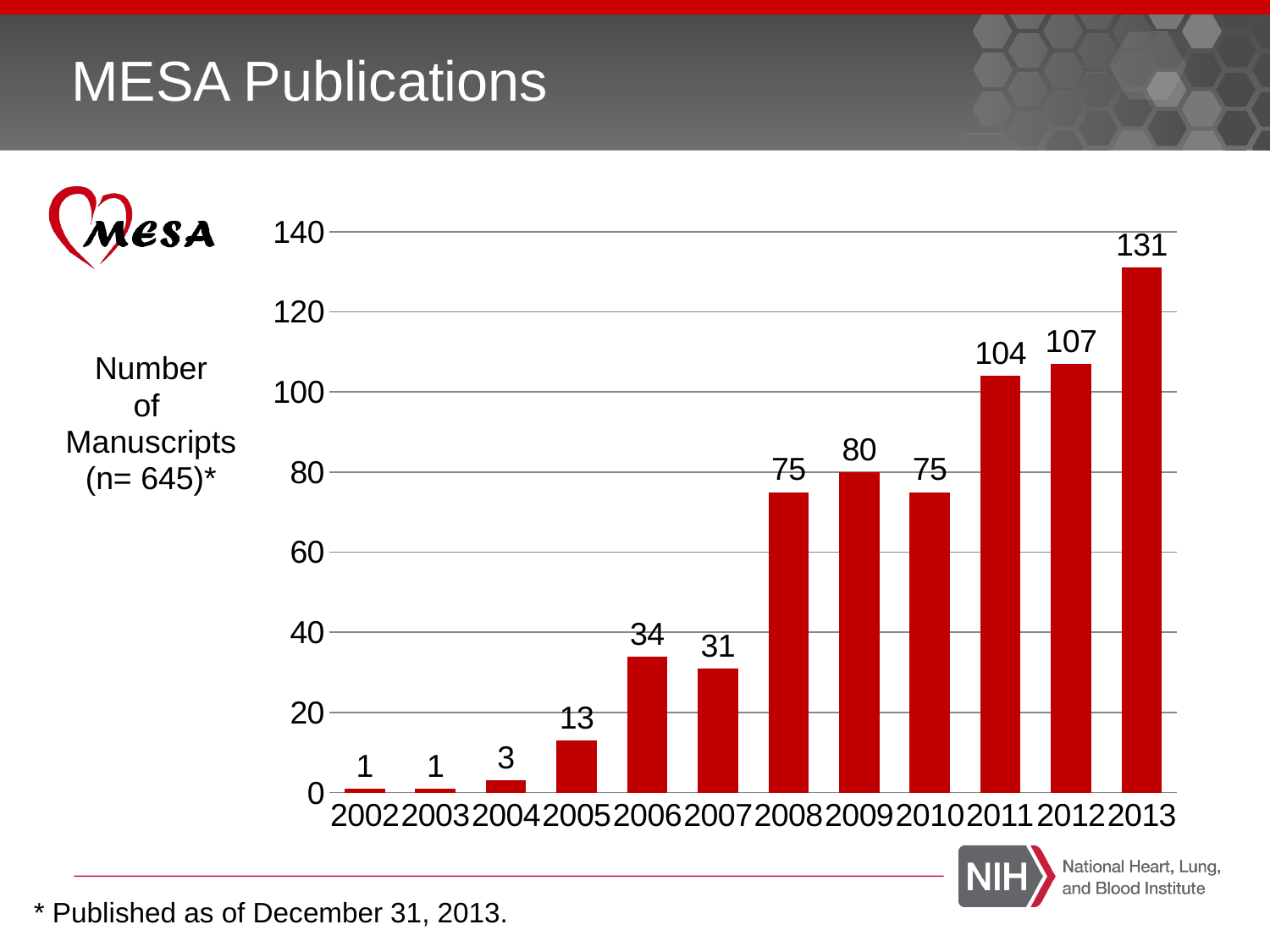
How many manuscripts were published in 2011? 104 What is the difference in manuscripts between 2008 and 2007? 44 How many manuscripts were published in 2013? 131 Which year has the lowest number of manuscripts, 2004 or 2005? 2004 Is the value for 2011 greater or less than 100? greater What is the number of manuscripts for 2006? 34 Which year had more manuscripts, 2009 or 2010? 2009 Which year has the highest number of manuscripts? 2013 What kind of chart is shown on the slide? Bar chart What is the difference in manuscripts between 2013 and 2012? 24 What is the total number of manuscripts stated in the axis label (n)? 645 How many years are shown on the x axis? 12